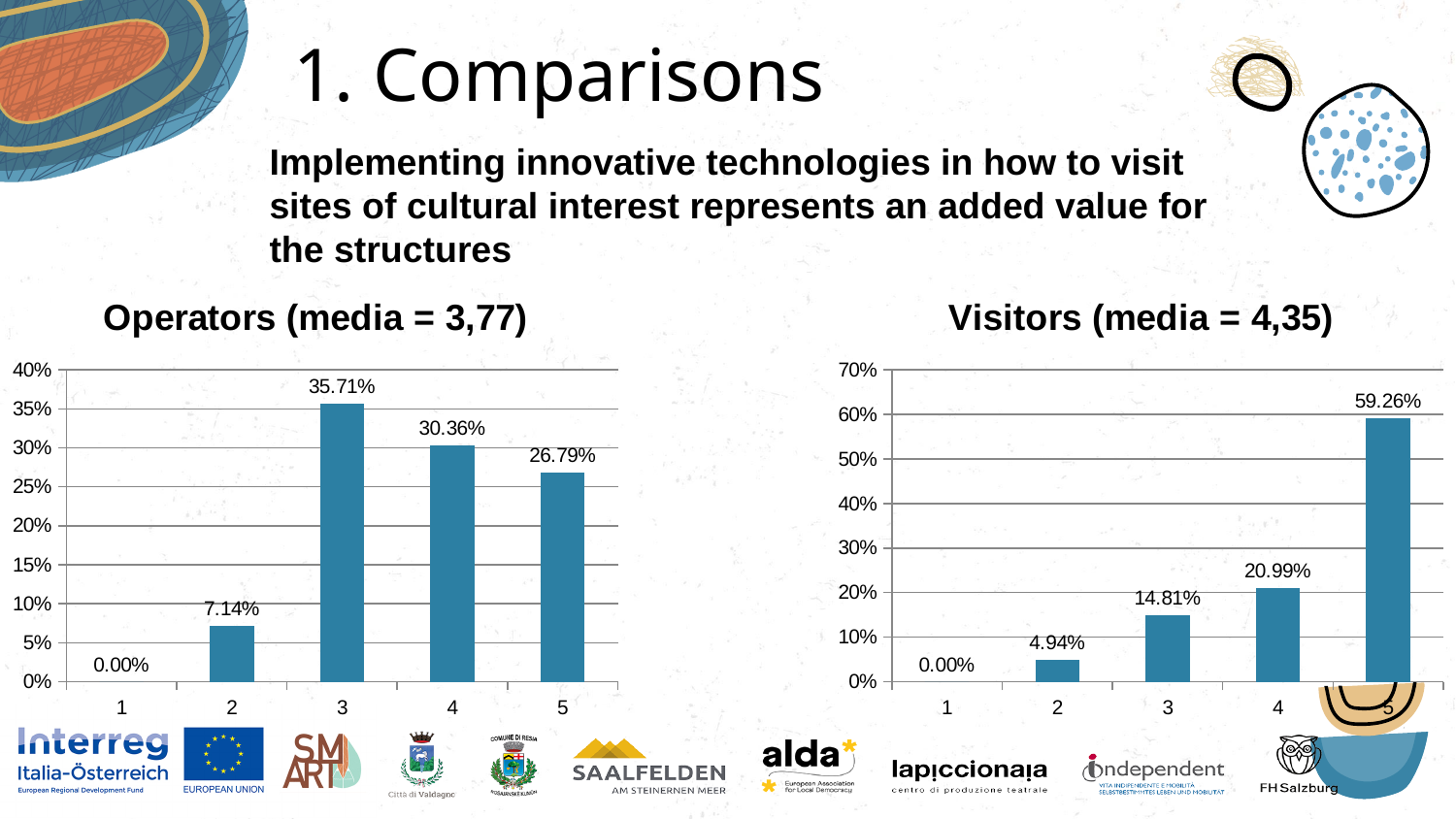
In the Operators (media = 3,77) chart, what is the difference between the values for category 4 and category 5? 3.57% In the Visitors (media = 4,35) chart, is the value for category 5 greater or less than 50%? greater In the Operators (media = 3,77) chart, what is the value for category 2? 7.14% In the Visitors (media = 4,35) chart, which category has the lowest value? 1 In the Visitors (media = 4,35) chart, what is the value for category 5? 59.26% In the Operators (media = 3,77) chart, what is the value for category 3? 35.71% In the Visitors (media = 4,35) chart, what is the value for category 3? 14.81% How many categories are shown on the x axis of the Operators (media = 3,77) chart? 5 What kind of chart is the Visitors (media = 4,35) chart? Bar chart In the Visitors (media = 4,35) chart, do the values rise or fall from category 1 to category 5? Rise In the Operators (media = 3,77) chart, which category has the highest value? 3 In the Visitors (media = 4,35) chart, which is larger: the value for category 4 or the value for category 2? Category 4